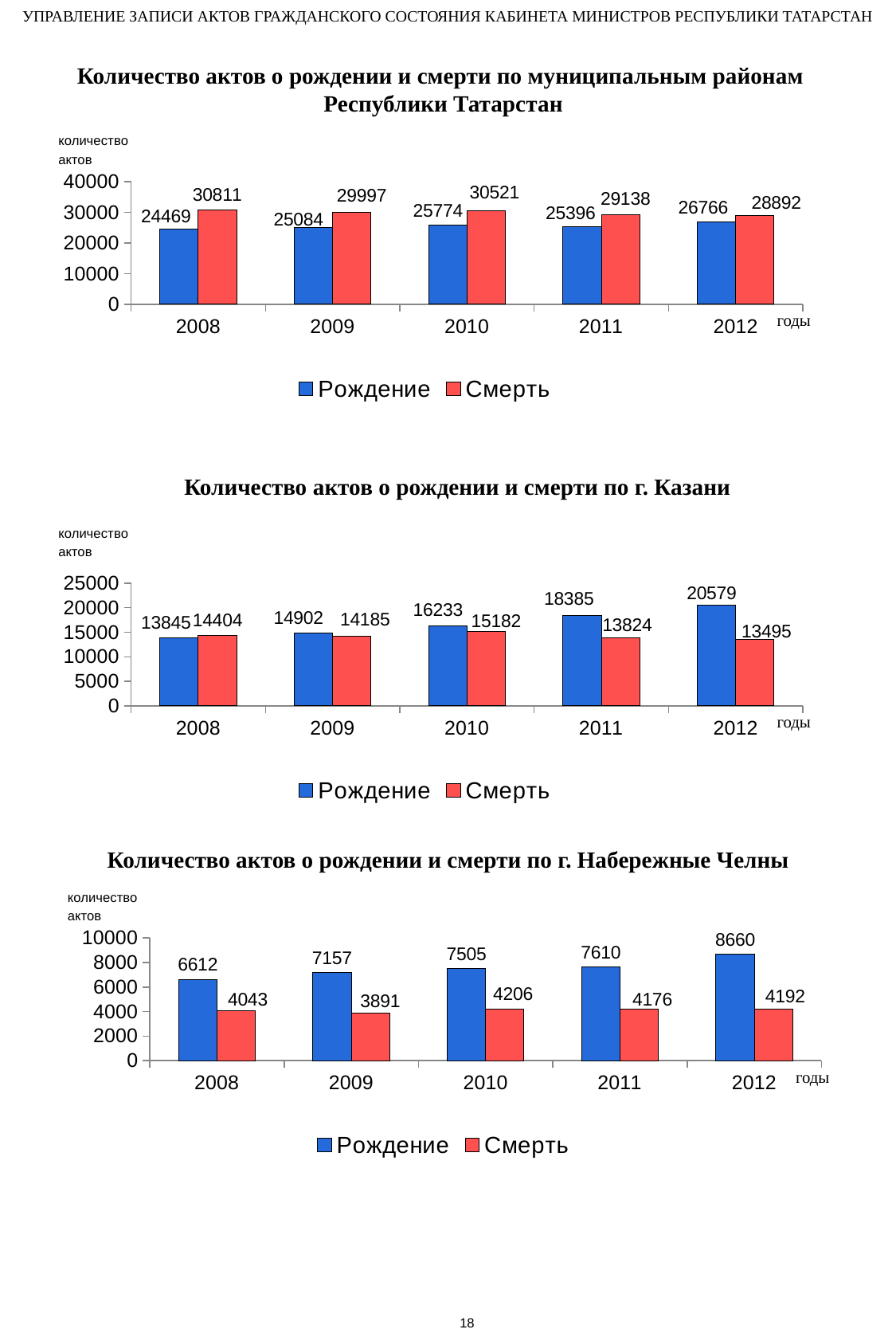
In the top chart (municipal districts of Tatarstan), what is the value for Рождение in 2010? 25774 In the top chart (municipal districts of Tatarstan), how many series does the legend list? 2 In the middle chart (г. Казани), which year has the lowest value for Рождение? 2008 In the middle chart (г. Казани), which is larger in 2012, Рождение or Смерть? Рождение In the middle chart (г. Казани), what is the value for Смерть in 2011? 13824 What kind of chart is the bottom chart (г. Набережные Челны)? bar chart In the top chart (municipal districts of Tatarstan), which year has the highest value for Смерть? 2008 In the bottom chart (г. Набережные Челны), what is the difference between Рождение and Смерть in 2012? 4468 In the top chart (municipal districts of Tatarstan), what is the difference between Смерть and Рождение in 2012? 2126 In the bottom chart (г. Набережные Челны), how many years are shown on the x axis? 5 In the middle chart (г. Казани), does the value for Рождение rise or fall from 2008 to 2012? rise In the bottom chart (г. Набережные Челны), what is the value for Смерть in 2009? 3891